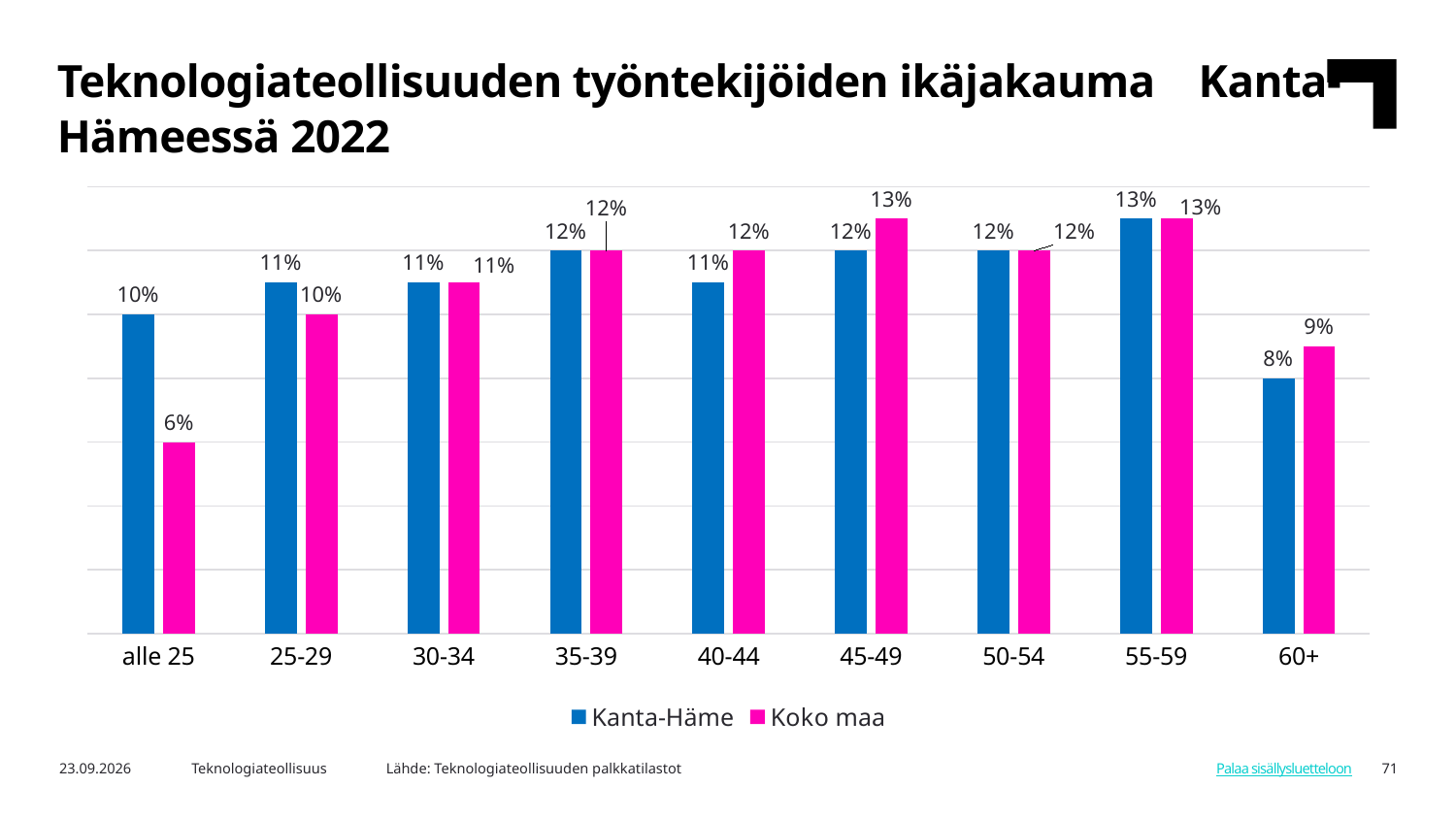
What is the difference between the Kanta-Häme and Koko maa values in the alle 25 age group? 4 percentage points How many series does the legend list? 2 What is the value for Kanta-Häme in the 60+ age group? 8% What is the value for Koko maa in the alle 25 age group? 6% What is the value for Koko maa in the 45-49 age group? 13% Which age group has the highest value for Kanta-Häme? 55-59 What kind of chart is shown on the slide? Bar chart In the 60+ age group, which series has the larger value, Kanta-Häme or Koko maa? Koko maa Which age group has the lowest value for Kanta-Häme? 60+ How many age groups are shown on the x axis? 9 Which age group has the lowest value for Koko maa? alle 25 What is the value for Kanta-Häme in the alle 25 age group? 10%